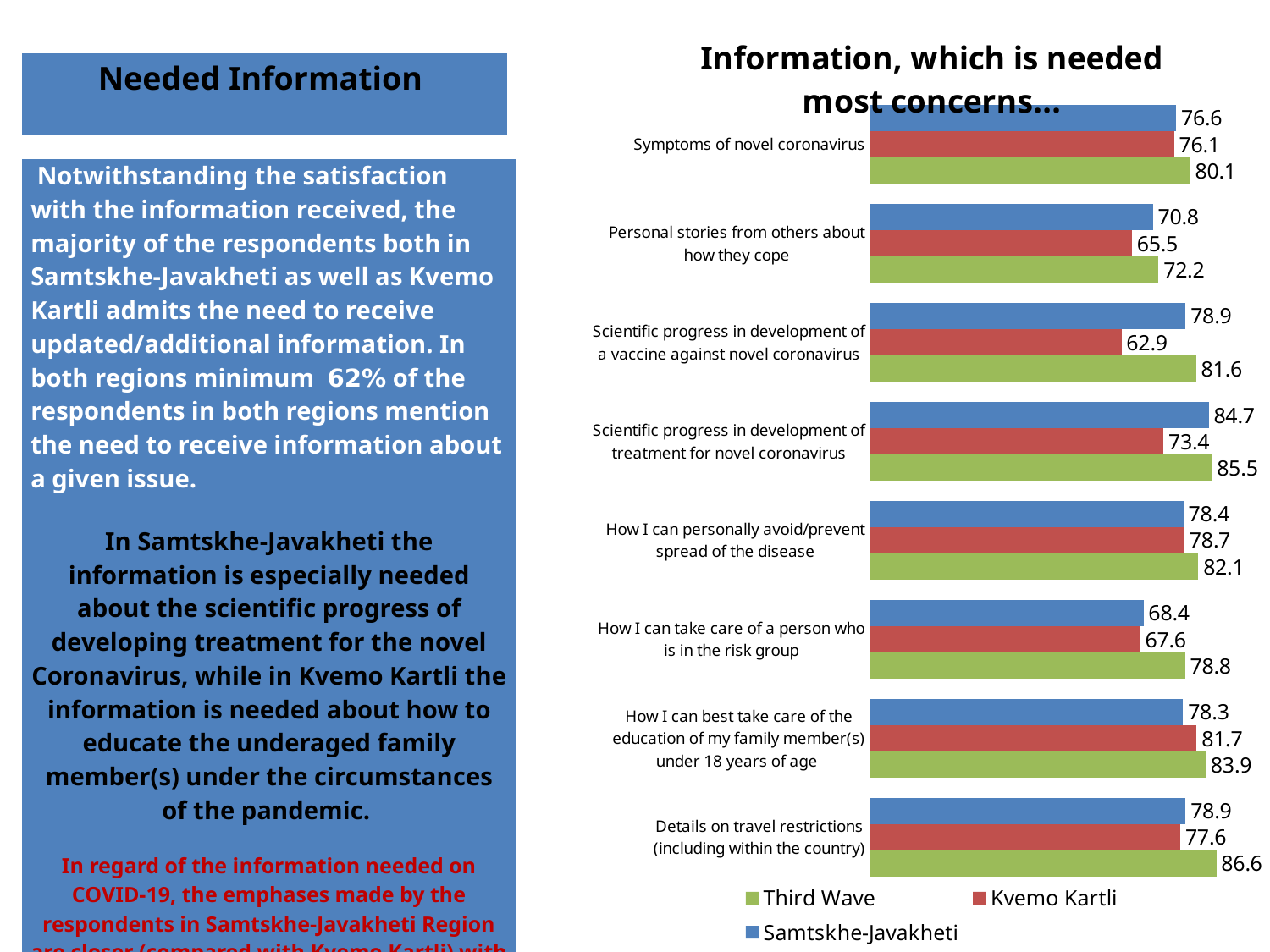
Which category has the highest Samtskhe-Javakheti value? Scientific progress in development of treatment for novel coronavirus What is the difference between the Samtskhe-Javakheti and Kvemo Kartli values for "Scientific progress in development of treatment for novel coronavirus"? 11.3 For "How I can best take care of the education of my family member(s) under 18 years of age", which is larger: the Kvemo Kartli value or the Samtskhe-Javakheti value? Kvemo Kartli What is the Samtskhe-Javakheti value for "Scientific progress in development of treatment for novel coronavirus"? 84.7 How many series does the legend list? 3 How many categories are shown in the chart? 8 What is the Kvemo Kartli value for "Personal stories from others about how they cope"? 65.5 What is the difference between the Third Wave and Kvemo Kartli values for "Scientific progress in development of a vaccine against novel coronavirus"? 18.7 Which category has the highest Third Wave value? Details on travel restrictions (including within the country) What is the Third Wave value for "Details on travel restrictions (including within the country)"? 86.6 What kind of chart is shown on the slide? Bar chart Which category has the lowest Kvemo Kartli value? Scientific progress in development of a vaccine against novel coronavirus